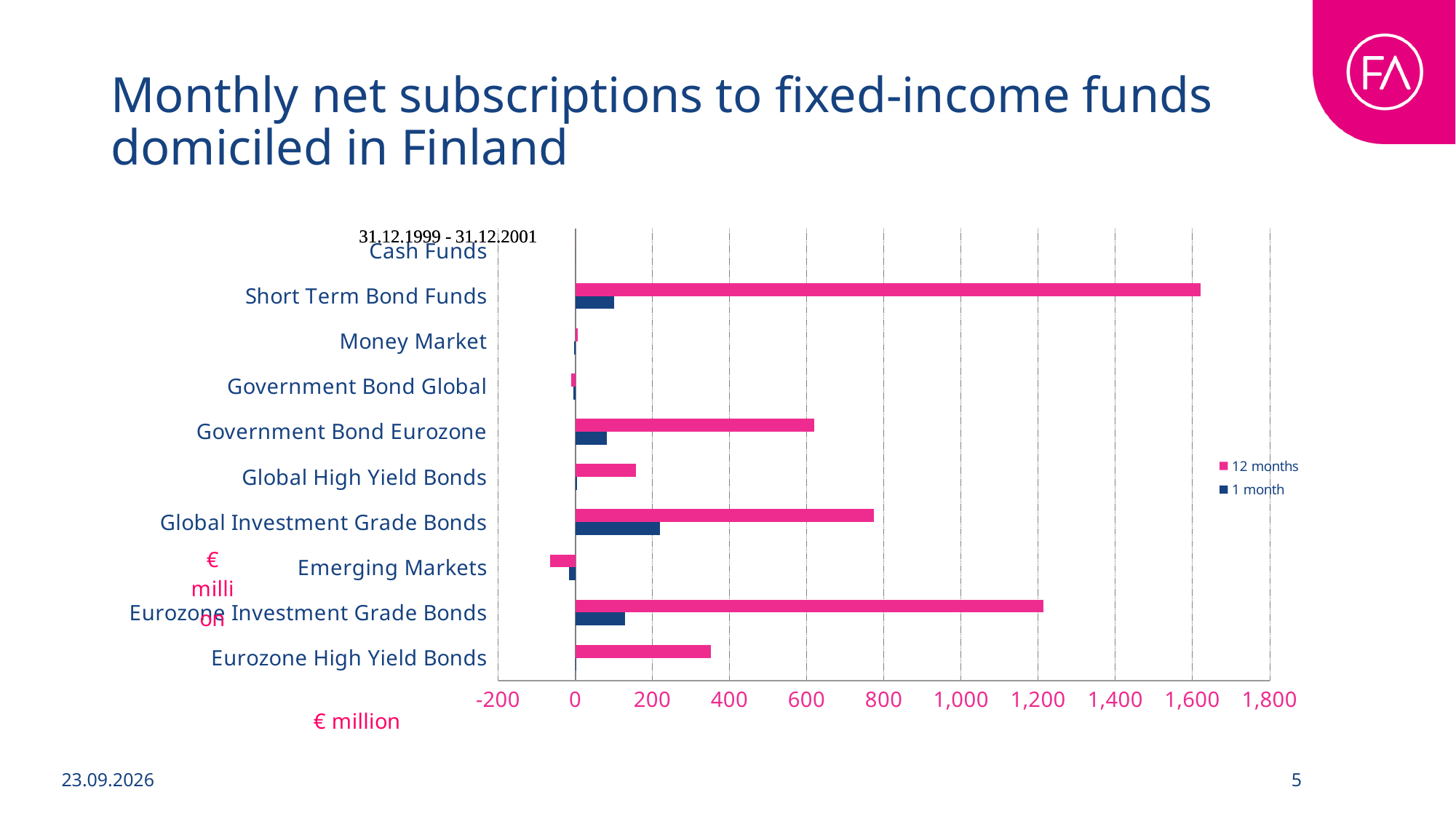
What kind of chart is shown on the slide? bar chart Which is larger for 12 months: Eurozone Investment Grade Bonds or Government Bond Eurozone? Eurozone Investment Grade Bonds Is the 12 months value for Eurozone Investment Grade Bonds greater or less than 1,000? greater Is the 12 months value for Short Term Bond Funds greater or less than 1,400? greater Is the 12 months value for Global High Yield Bonds greater or less than 200? less What unit is shown on the x axis of the chart? € million Which category has the lowest 12 months value? Emerging Markets Which category has the highest 1 month value? Global Investment Grade Bonds How many fund categories are shown on the chart? 10 Which category has the highest 12 months value? Short Term Bond Funds How many series does the legend list? 2